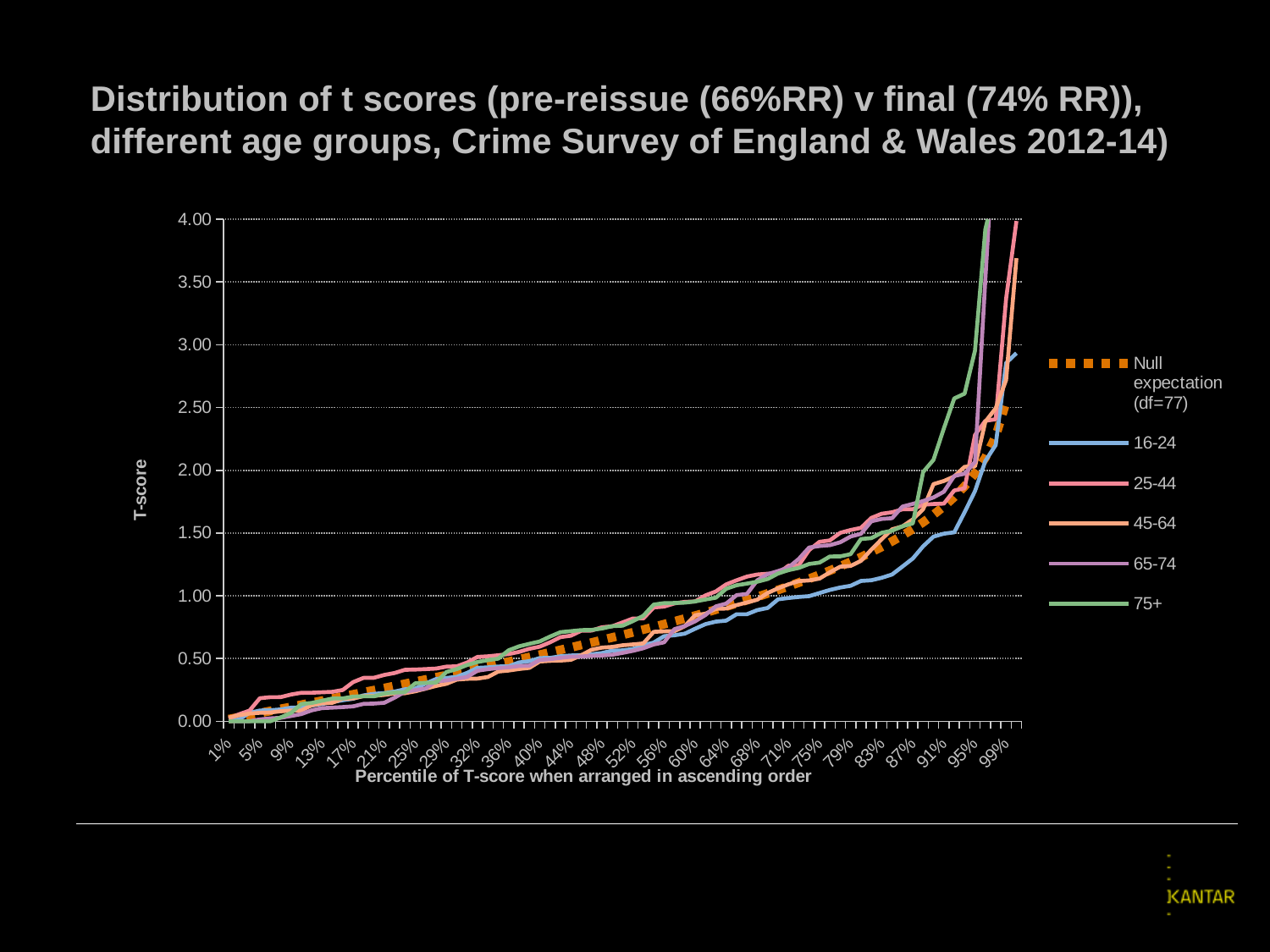
Which series is drawn as a dashed line in the legend? Null expectation (df=77) Is the value for the 45-64 series at the 99% percentile greater or less than 3.00? less At the 95% percentile, which series has the higher value: 75+ or 16-24? 75+ Is the value for the 16-24 series at the 83% percentile greater or less than 1.50? less Do the T-score values rise or fall as the percentile increases along the x axis? rise What kind of chart is shown on the slide? line chart Is the value for the 75+ series at the 95% percentile greater or less than 2.00? greater How many series does the legend list? 6 What is the title of the vertical axis? T-score